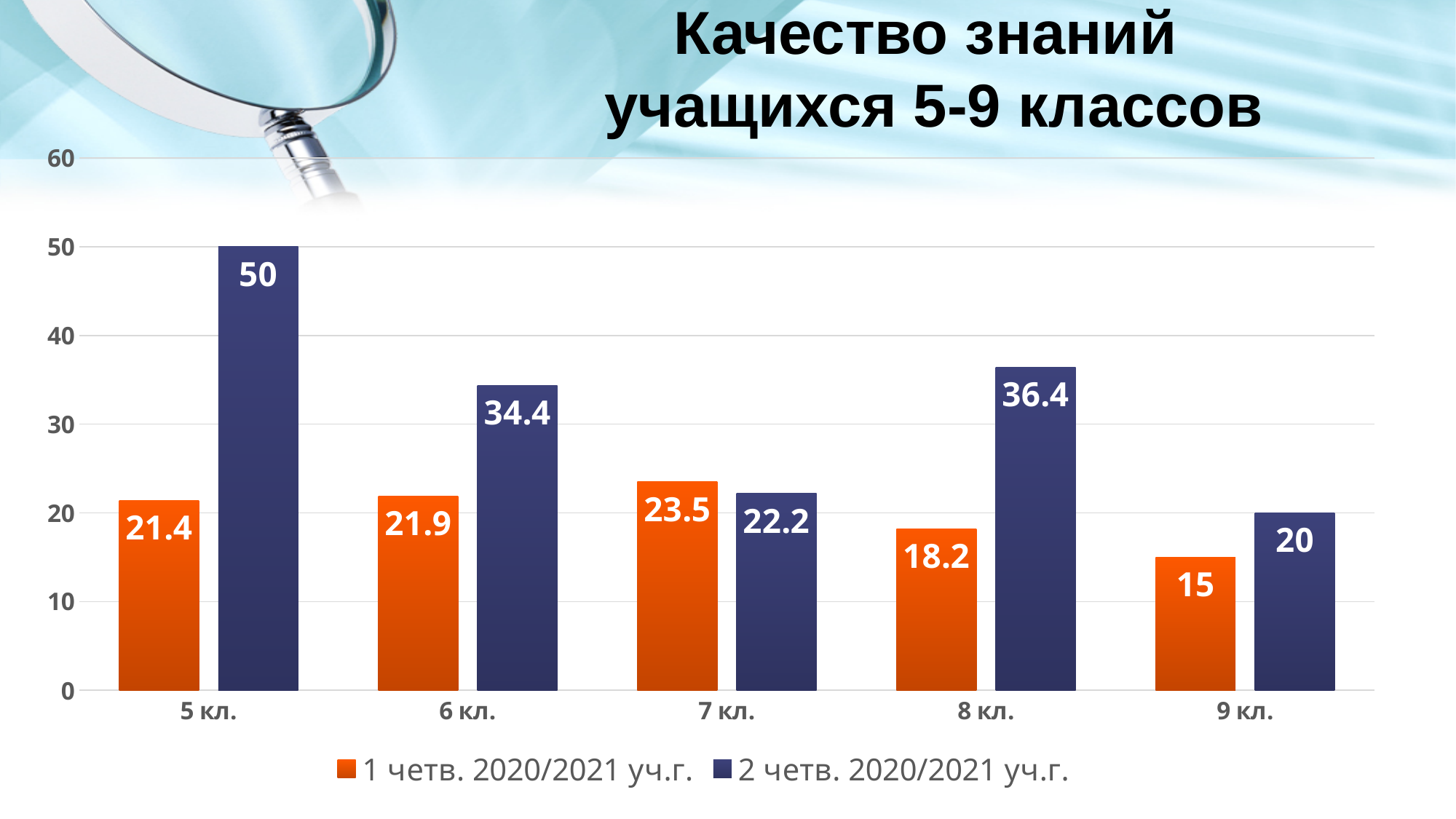
Which class has the lowest value in the series 1 четв. 2020/2021 уч.г.? 9 кл. Which class has the highest value in the series 2 четв. 2020/2021 уч.г.? 5 кл. For 7 кл., which series has the larger value: 1 четв. 2020/2021 уч.г. or 2 четв. 2020/2021 уч.г.? 1 четв. 2020/2021 уч.г. What kind of chart is shown on the slide? bar chart Is the value for 8 кл. in the series 2 четв. 2020/2021 уч.г. greater or less than 30? greater What is the value for 9 кл. in the series 2 четв. 2020/2021 уч.г.? 20 How many series does the legend list? 2 How many classes are shown on the x axis? 5 What is the difference between the 2 четв. and 1 четв. values for 5 кл.? 28.6 What is the title of the chart? Качество знаний учащихся 5-9 классов What is the value for 8 кл. in the series 1 четв. 2020/2021 уч.г.? 18.2 What is the value for 5 кл. in the series 2 четв. 2020/2021 уч.г.? 50